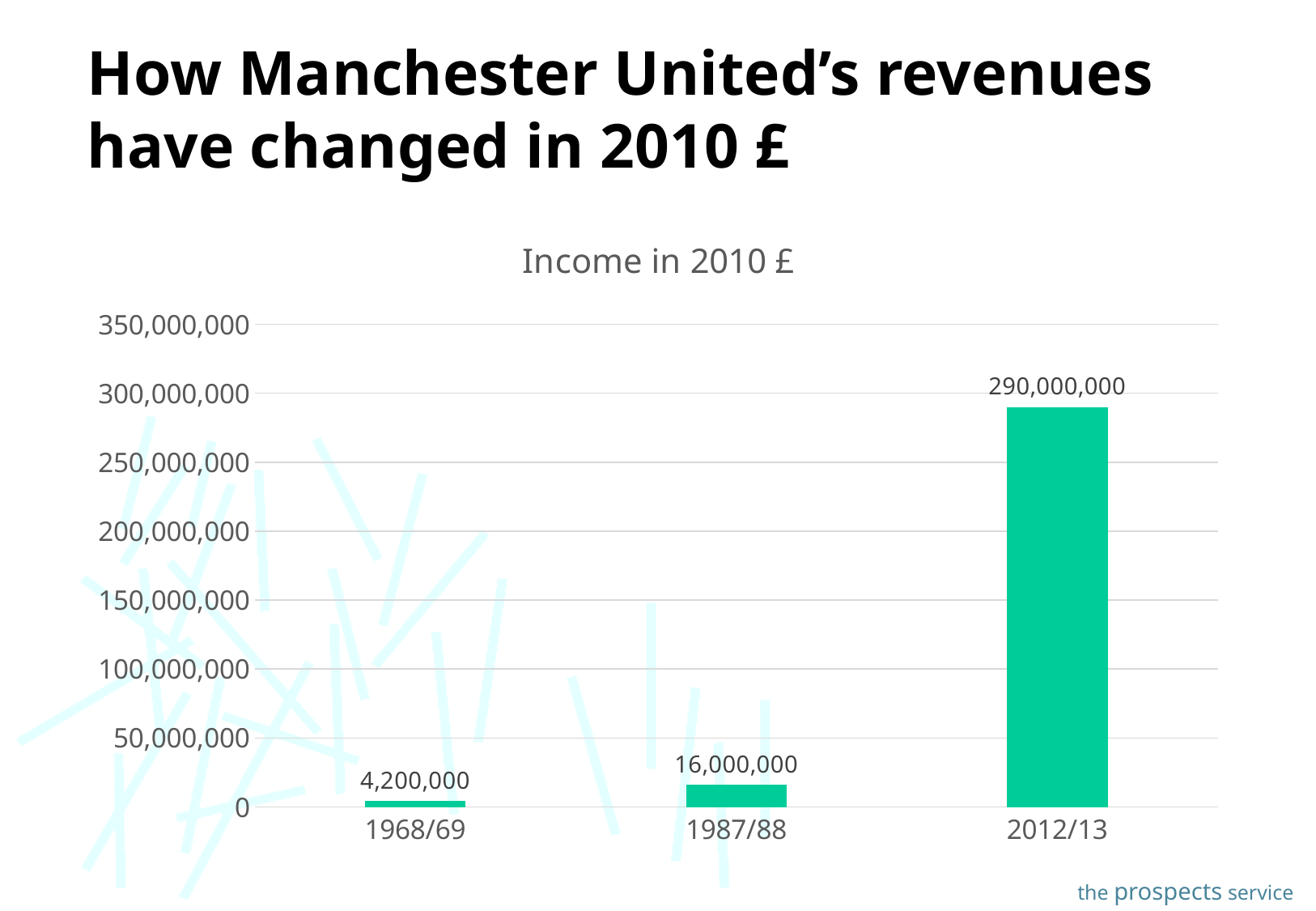
Do the income values rise or fall from 1968/69 to 2012/13? Rise What is the income in 2010 £ for 2012/13? 290,000,000 What is the difference in income between 1987/88 and 1968/69? 11,800,000 What is the difference in income between 2012/13 and 1987/88? 274,000,000 Which season has the lowest income? 1968/69 What is the income in 2010 £ for 1987/88? 16,000,000 What kind of chart is shown on the slide? Bar chart Which season has the highest income? 2012/13 Is the value for 2012/13 greater or less than 250,000,000? greater What is the income in 2010 £ for 1968/69? 4,200,000 Which is larger, the income for 1987/88 or for 1968/69? 1987/88 How many seasons are shown on the chart? 3